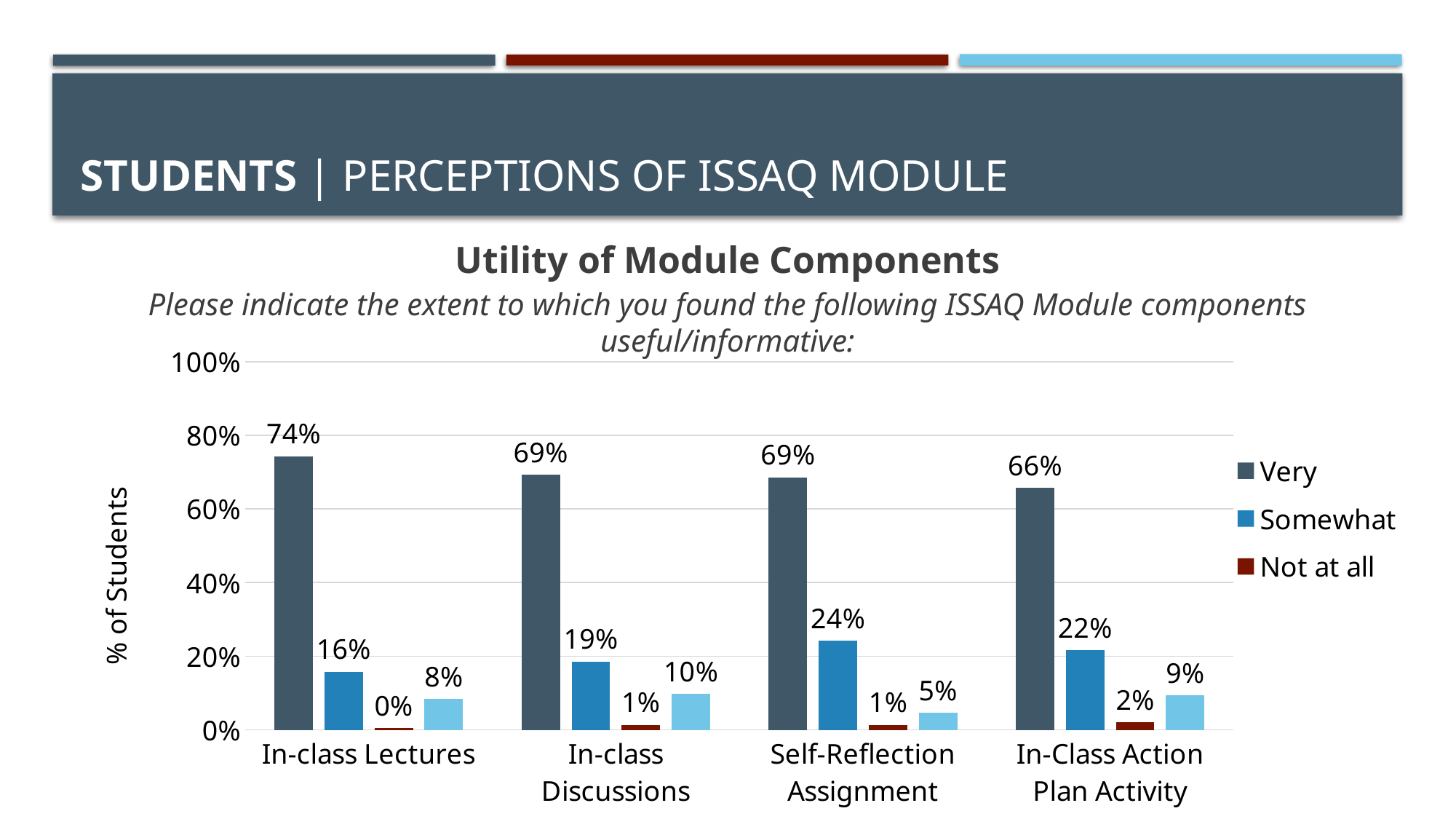
What is the 'Not at all' value for the In-Class Action Plan Activity? 2% Is the 'Very' value for Self-Reflection Assignment greater or less than 60%? greater What kind of chart is shown on the slide? Bar chart How many series does the legend list? 3 What is the difference between the 'Very' values for In-class Lectures and In-Class Action Plan Activity? 8% What is the title of the chart? Utility of Module Components Which module component has the highest 'Very' percentage? In-class Lectures Which module component has the lowest 'Very' percentage? In-Class Action Plan Activity Which is larger: the 'Somewhat' value for In-class Discussions or for In-Class Action Plan Activity? In-Class Action Plan Activity What is the 'Somewhat' value for the Self-Reflection Assignment? 24% What percentage of students found In-class Lectures 'Very' useful? 74% How many module components are shown on the x axis? 4